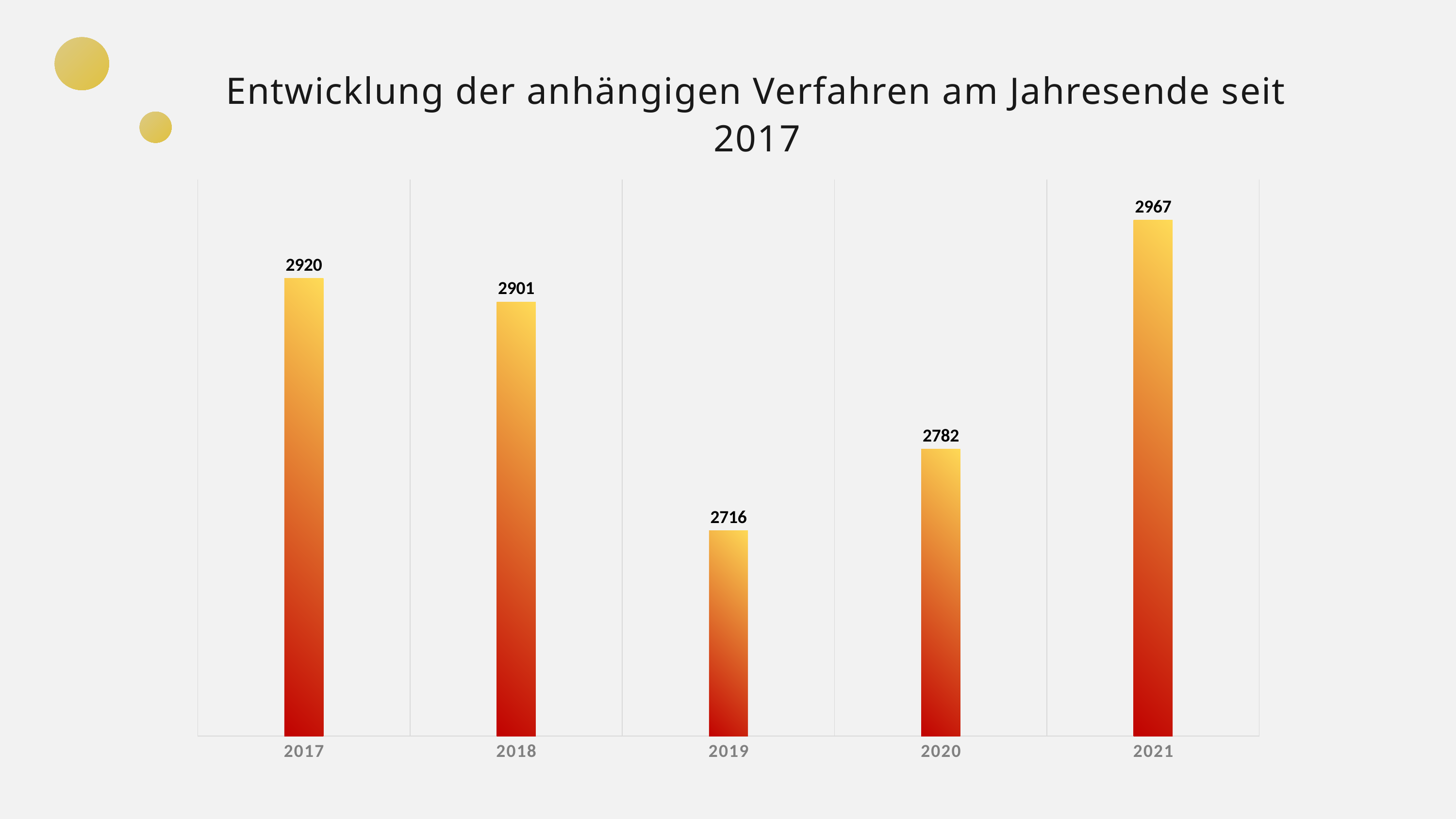
What is the difference between the values for 2017 and 2018? 19 How many years are shown on the chart? 5 Which year has the lowest value? 2019 What kind of chart is shown on the slide? bar chart Do the values rise or fall from 2019 to 2021? rise Which is larger, the value for 2020 or the value for 2018? 2018 What is the difference between the values for 2021 and 2019? 251 What is the value for 2017? 2920 What is the value for 2021? 2967 What is the title of the chart? Entwicklung der anhängigen Verfahren am Jahresende seit 2017 Which year has the highest value? 2021 What is the value for 2019? 2716